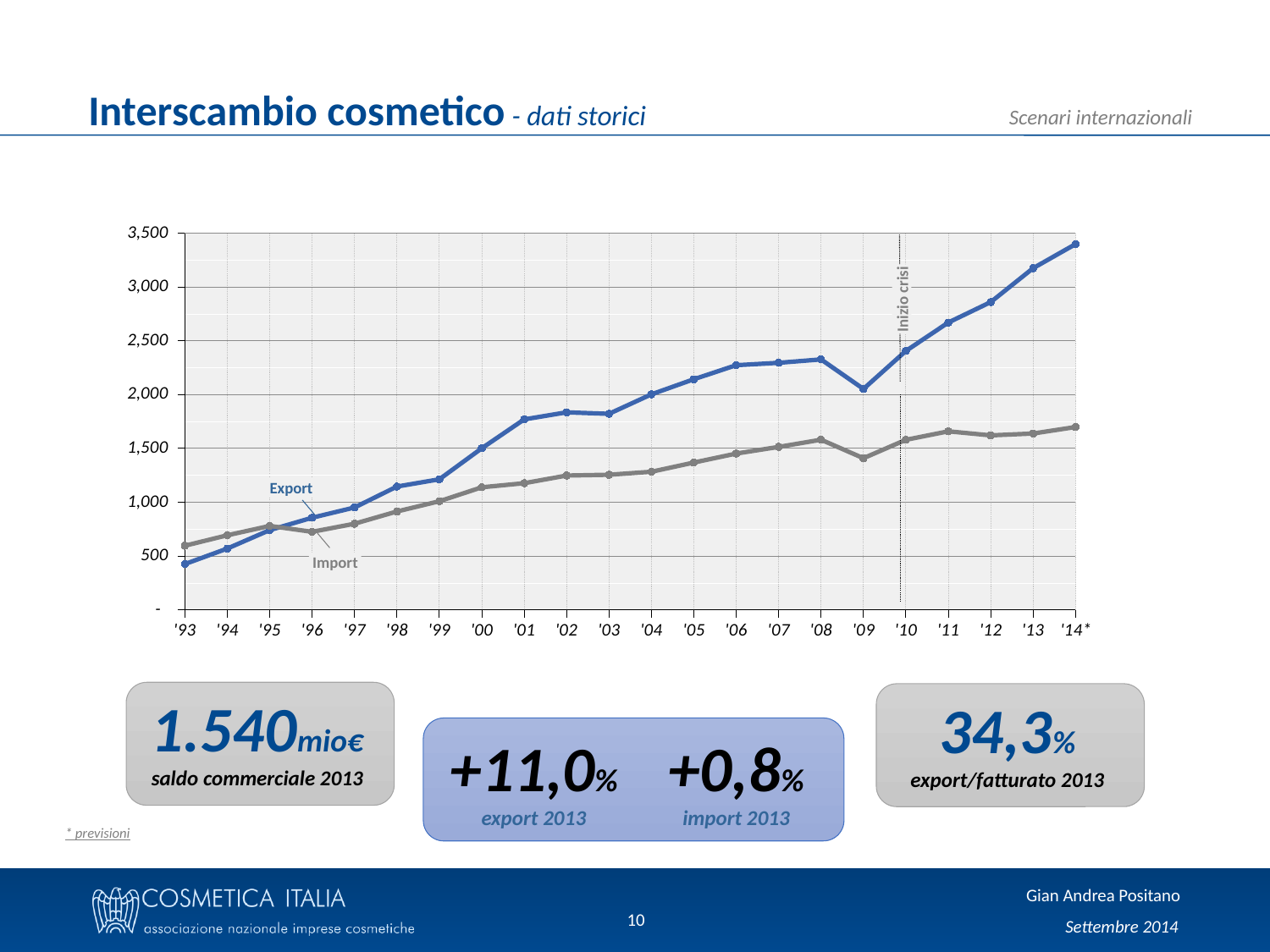
Is the Export value for '09 greater or less than 2,500? less How many years are shown along the x axis of the chart? 22 In which year does the Export series reach its highest value? '14* In which year is the Export series at its lowest value? '93 How many series are plotted on the chart? 2 Is the Import value for '14* greater or less than 1,500? greater Is the Export value for '14* greater or less than 3,000? greater What kind of chart is shown on the slide? line chart Which series has the larger value in '93, Export or Import? Import What label is attached to the vertical dashed line at '10 on the chart? Inizio crisi Which series has the larger value in '13, Export or Import? Export